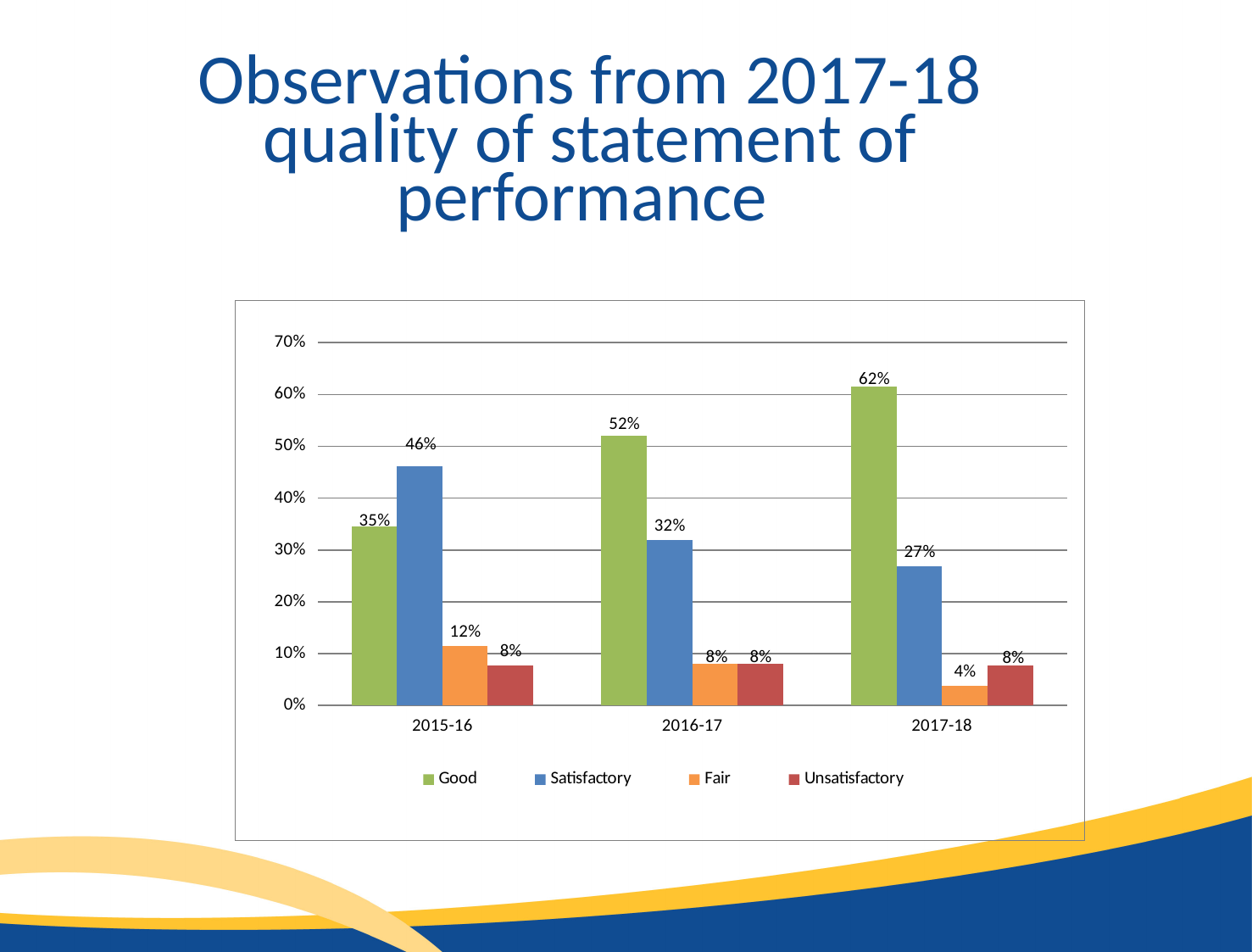
What is the value for Fair in 2017-18? 4% What kind of chart is shown on the slide? Bar chart What is the value for Unsatisfactory in 2016-17? 8% What is the value for Satisfactory in 2015-16? 46% Which is larger in 2015-16, Good or Satisfactory? Satisfactory In which year is the Satisfactory value lowest? 2017-18 What is the value for Good in 2017-18? 62% Does the Good value rise or fall from 2015-16 to 2017-18? Rise In which year is the Good value highest? 2017-18 How many year categories are shown on the x axis? 3 How many series does the legend list? 4 What is the difference between the Good values for 2017-18 and 2015-16? 27%